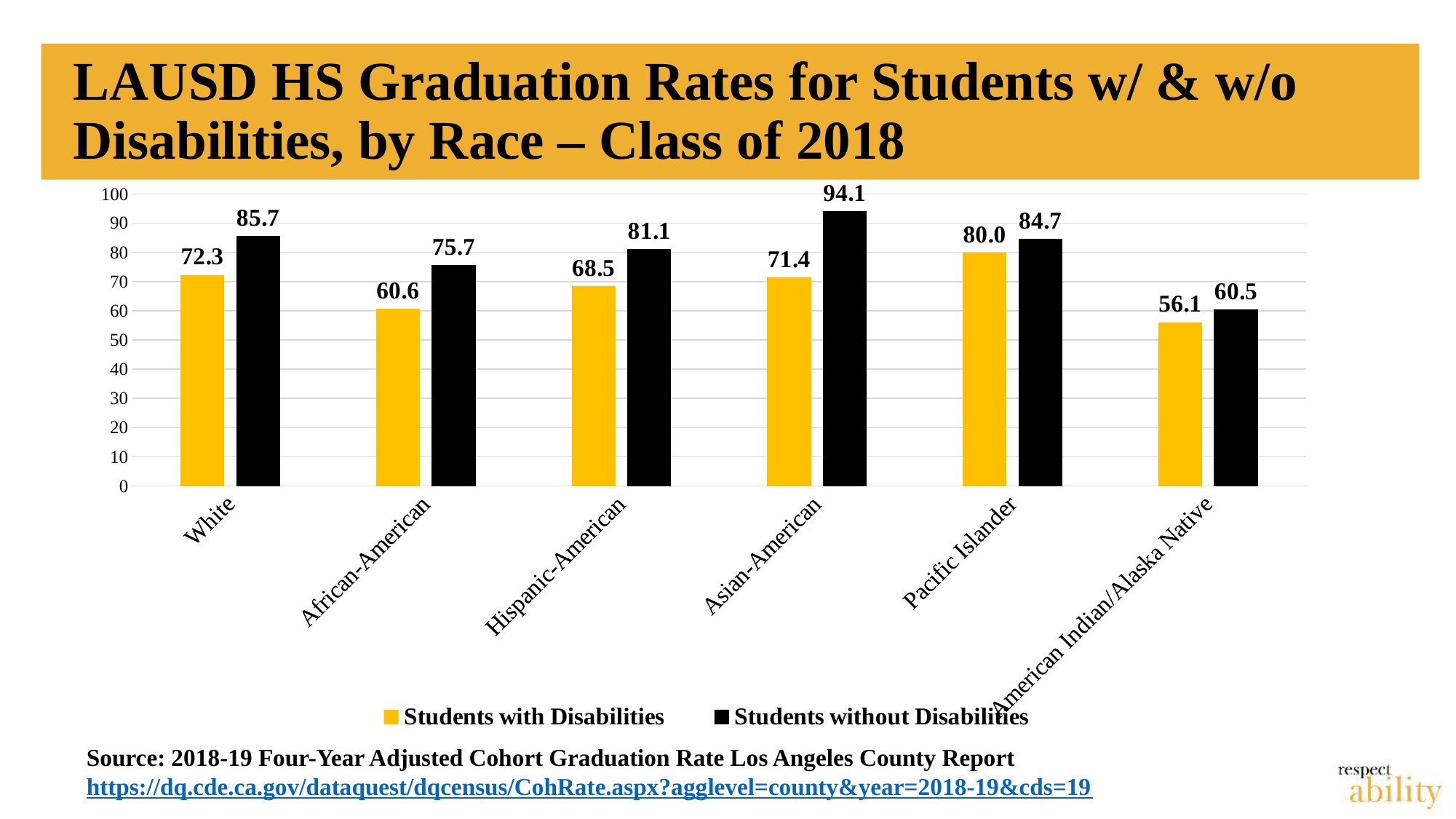
What is the graduation rate for American Indian/Alaska Native students with disabilities? 56.1 What is the difference between the graduation rates of Pacific Islander students without disabilities and with disabilities? 4.7 How many race categories are shown on the x axis? 6 Which colour represents Students with Disabilities in the chart? Yellow Which race category has the lowest graduation rate for students with disabilities? American Indian/Alaska Native What is the difference between the graduation rates of Asian-American students without disabilities and Asian-American students with disabilities? 22.7 What is the graduation rate for White students with disabilities? 72.3 How many series does the legend list? 2 What is the graduation rate for Asian-American students without disabilities? 94.1 Which race category has the highest graduation rate for students without disabilities? Asian-American What kind of chart is shown on the slide? Bar chart Which is larger: the graduation rate for Hispanic-American students with disabilities or for African-American students with disabilities? Hispanic-American students with disabilities